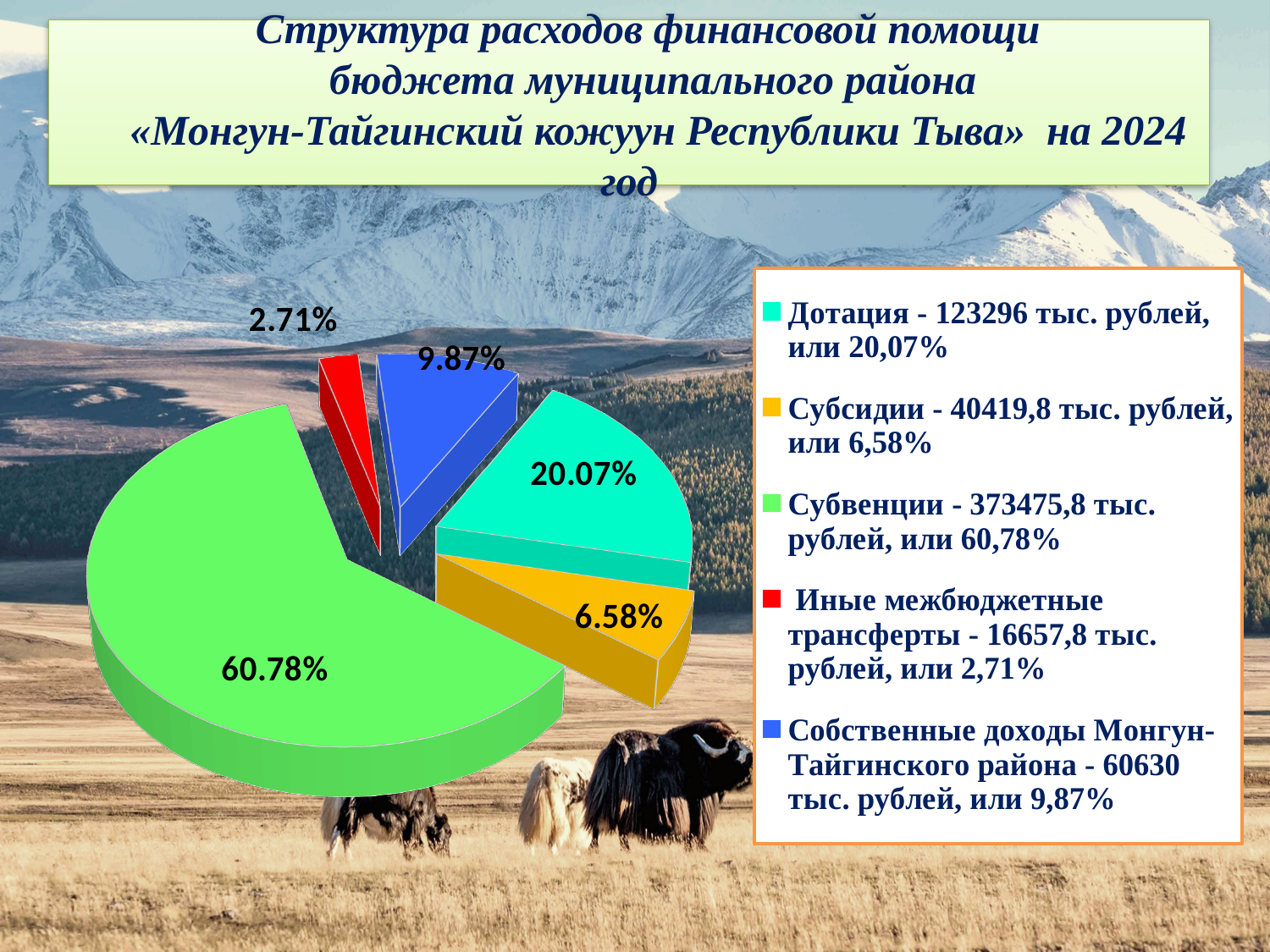
What share of the pie does Субвенции account for? 60.78% According to the legend, what amount in тыс. рублей corresponds to Субсидии? 40419,8 тыс. рублей Which category has the largest slice of the pie? Субвенции Which is larger: the share for Дотация or the share for Собственные доходы Монгун-Тайгинского района? Дотация What is the difference in percentage points between the Субвенции slice and the Дотация slice? 40.71 What share of the pie does Собственные доходы Монгун-Тайгинского района account for? 9.87% What share of the pie does Иные межбюджетные трансферты account for? 2.71% Which category has the smallest slice of the pie? Иные межбюджетные трансферты What kind of chart is shown on the slide? Pie chart How many slices does the pie chart have? 5